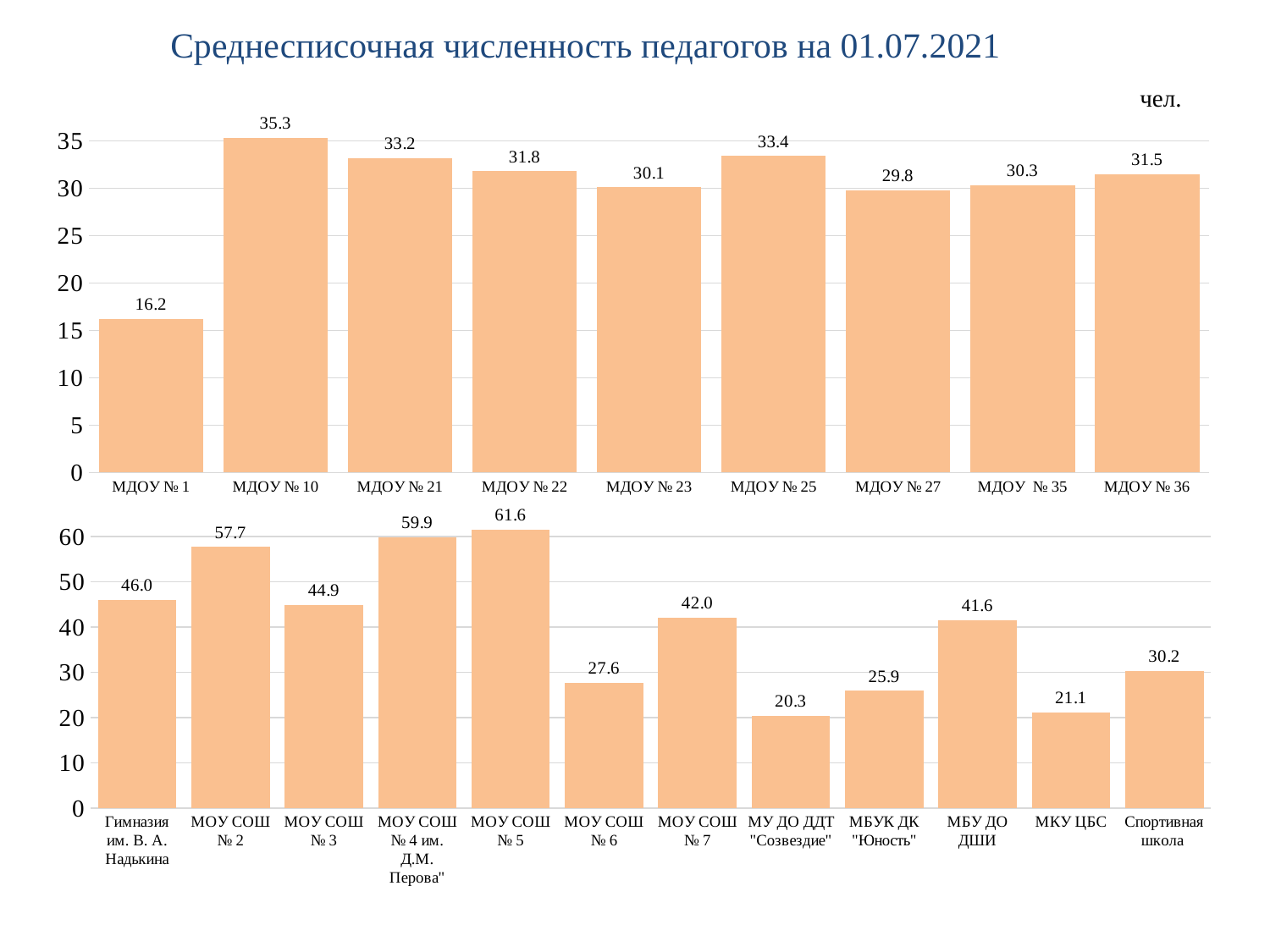
In the bottom chart, which category has the highest value? МОУ СОШ № 5 In the bottom chart, how many categories are shown? 12 What kind of chart is the top chart? Bar chart In the top chart, which category has the lowest value? МДОУ № 1 In the top chart, what is the difference between the values for МДОУ № 10 and МДОУ № 1? 19.1 In the top chart, how many categories are shown? 9 In the bottom chart, which is larger: the value for МОУ СОШ № 2 or the value for Гимназия им. В. А. Надькина? МОУ СОШ № 2 In the top chart, which category has the highest value? МДОУ № 10 In the top chart, what is the value for МДОУ № 1? 16.2 In the bottom chart, what is the difference between the values for МОУ СОШ № 5 and МОУ СОШ № 6? 34.0 In the bottom chart, which category has the lowest value? МУ ДО ДДТ "Созвездие" In the bottom chart, what is the value for МБУ ДО ДШИ? 41.6